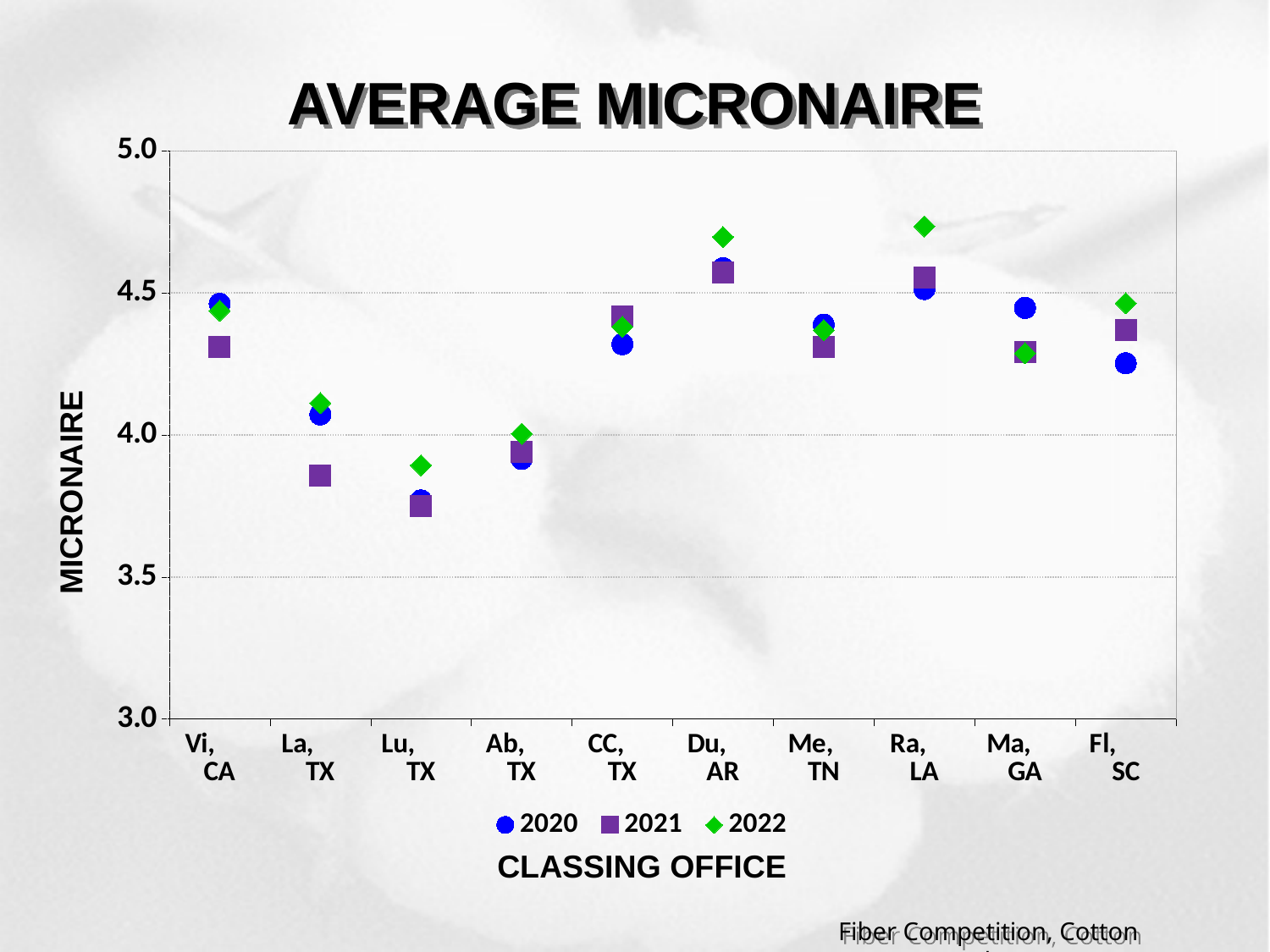
Is the 2022 value for Du, AR greater or less than 4.5? greater What kind of chart is this? scatter chart Which classing office has the highest 2020 micronaire? Du, AR What is the label of the x axis? CLASSING OFFICE How many series does the legend list? 3 For Vi, CA, which is larger: the 2020 value or the 2021 value? 2020 Which classing office has the lowest 2021 micronaire? Lu, TX How many classing offices are shown on the x axis? 10 Which classing office has the lowest 2022 micronaire? Lu, TX What is the title of the chart? AVERAGE MICRONAIRE Is the 2021 value for La, TX greater or less than 4.0? less For Fl, SC, which is larger: the 2022 value or the 2020 value? 2022